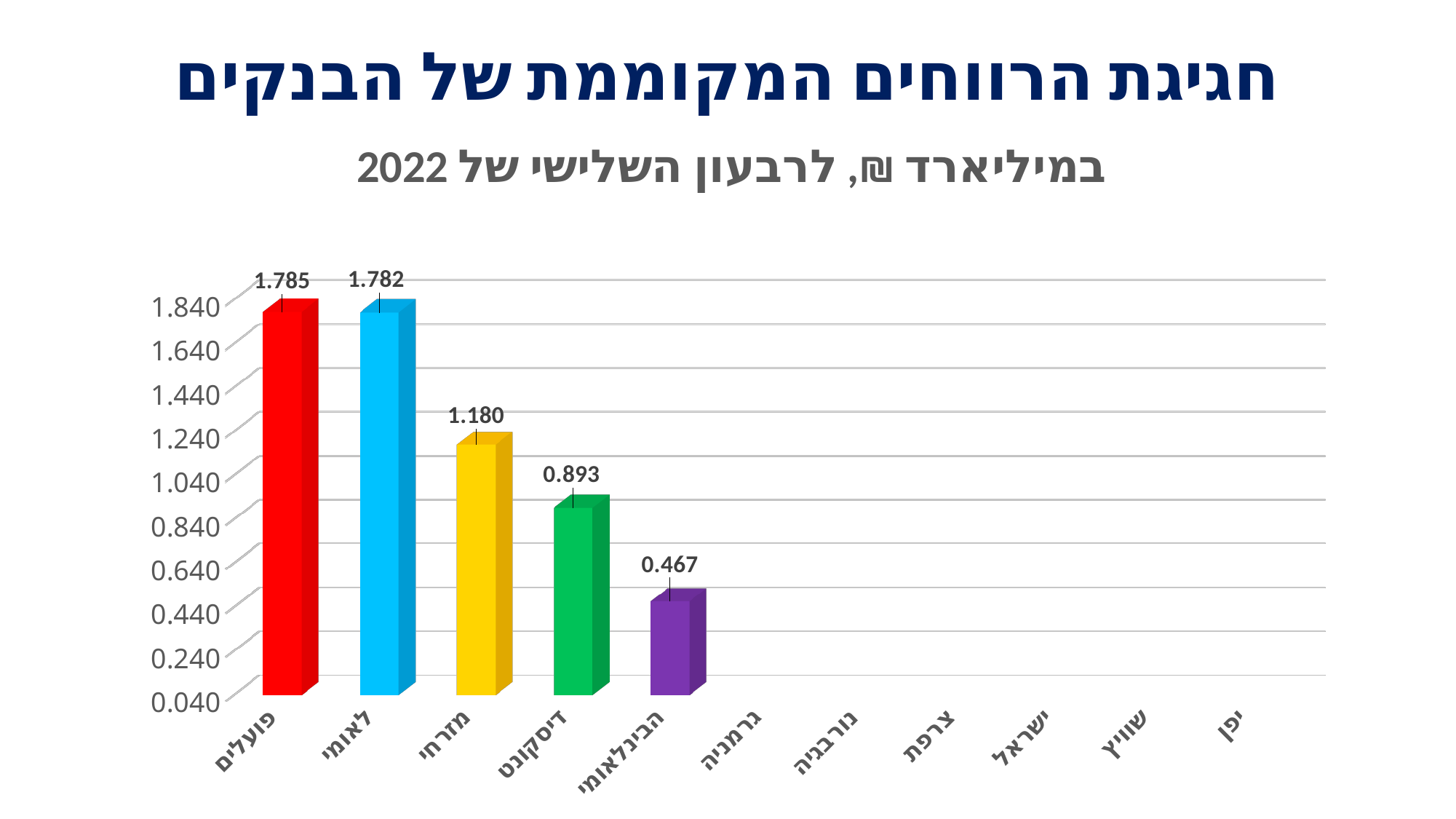
What is the value for דיסקונט? 0.893 What is the value for פועלים? 1.785 What is the value for לאומי? 1.782 What is the difference between the values for מזרחי and דיסקונט? 0.287 What colour is the bar for לאומי? light blue Which is larger, the value for דיסקונט or the value for הבינלאומי? דיסקונט Which bank has the highest value according to the data labels? פועלים What is the value for הבינלאומי? 0.467 Which of the banks with a plotted bar has the lowest value? הבינלאומי What is the value for מזרחי? 1.180 How many bars are plotted on the chart? 5 What kind of chart is shown on the slide? bar chart